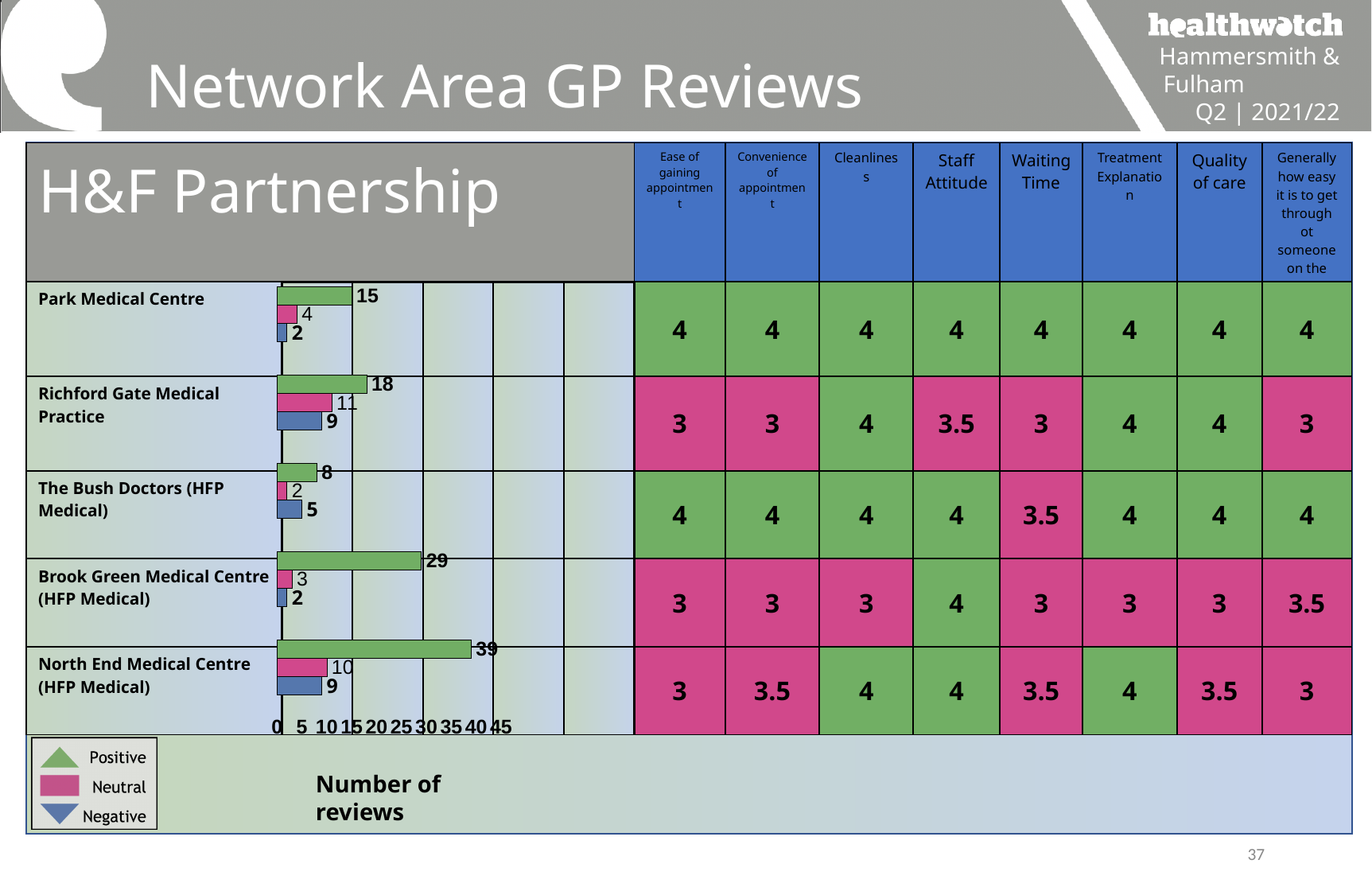
Is the number of positive reviews for Brook Green Medical Centre (HFP Medical) greater or less than 25? greater Which practice has the highest number of positive reviews in the bar chart? North End Medical Centre (HFP Medical) How many series does the bar chart legend list? 3 What type of chart is used to show the number of reviews? Bar chart Which has more neutral reviews in the bar chart: Richford Gate Medical Practice or North End Medical Centre (HFP Medical)? Richford Gate Medical Practice How many neutral reviews does Richford Gate Medical Practice have in the bar chart? 11 What is the total number of reviews (positive, neutral and negative) for Richford Gate Medical Practice? 38 Which practice has the lowest number of positive reviews in the bar chart? The Bush Doctors (HFP Medical) How many positive reviews does Park Medical Centre have in the bar chart? 15 How many practices are shown in the bar chart? 5 What is the difference between the positive reviews for North End Medical Centre (HFP Medical) and Brook Green Medical Centre (HFP Medical)? 10 How many negative reviews does The Bush Doctors (HFP Medical) have in the bar chart? 5